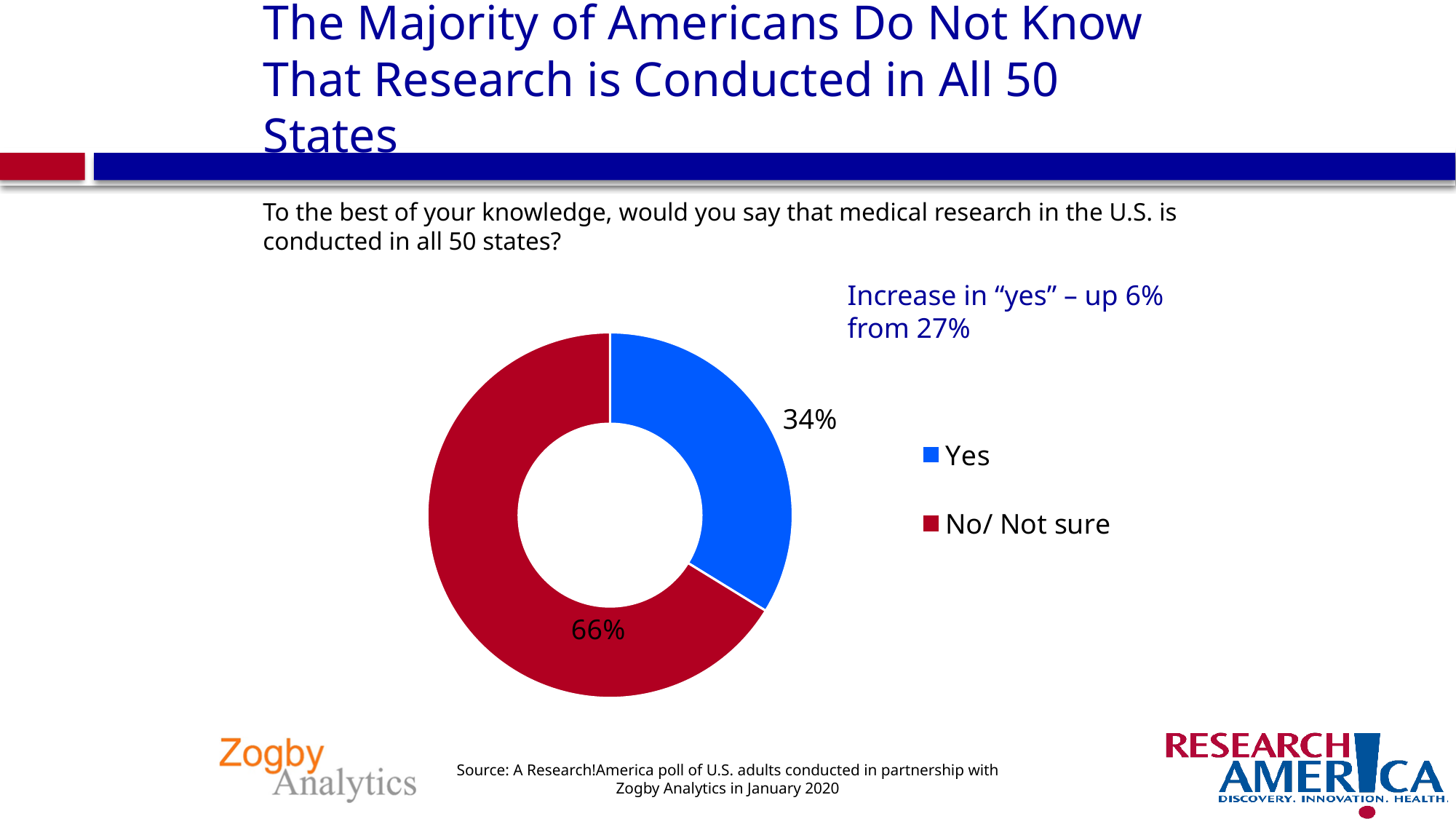
What percentage of respondents answered "No/ Not sure"? 66% What is the difference in percentage points between "No/ Not sure" and "Yes"? 32 According to the annotation, what was the previous "yes" percentage? 27% Which response has the smallest share of the chart? Yes What colour is the "No/ Not sure" slice? Red What kind of chart is shown on the slide? Pie chart (doughnut) How many entries does the legend list? 2 Which is larger, the share for "Yes" or the share for "No/ Not sure"? No/ Not sure Which response has the largest share of the chart? No/ Not sure What percentage of respondents answered "Yes"? 34% What share of the pie does the "Yes" slice represent? 34% How many categories does the chart show? 2